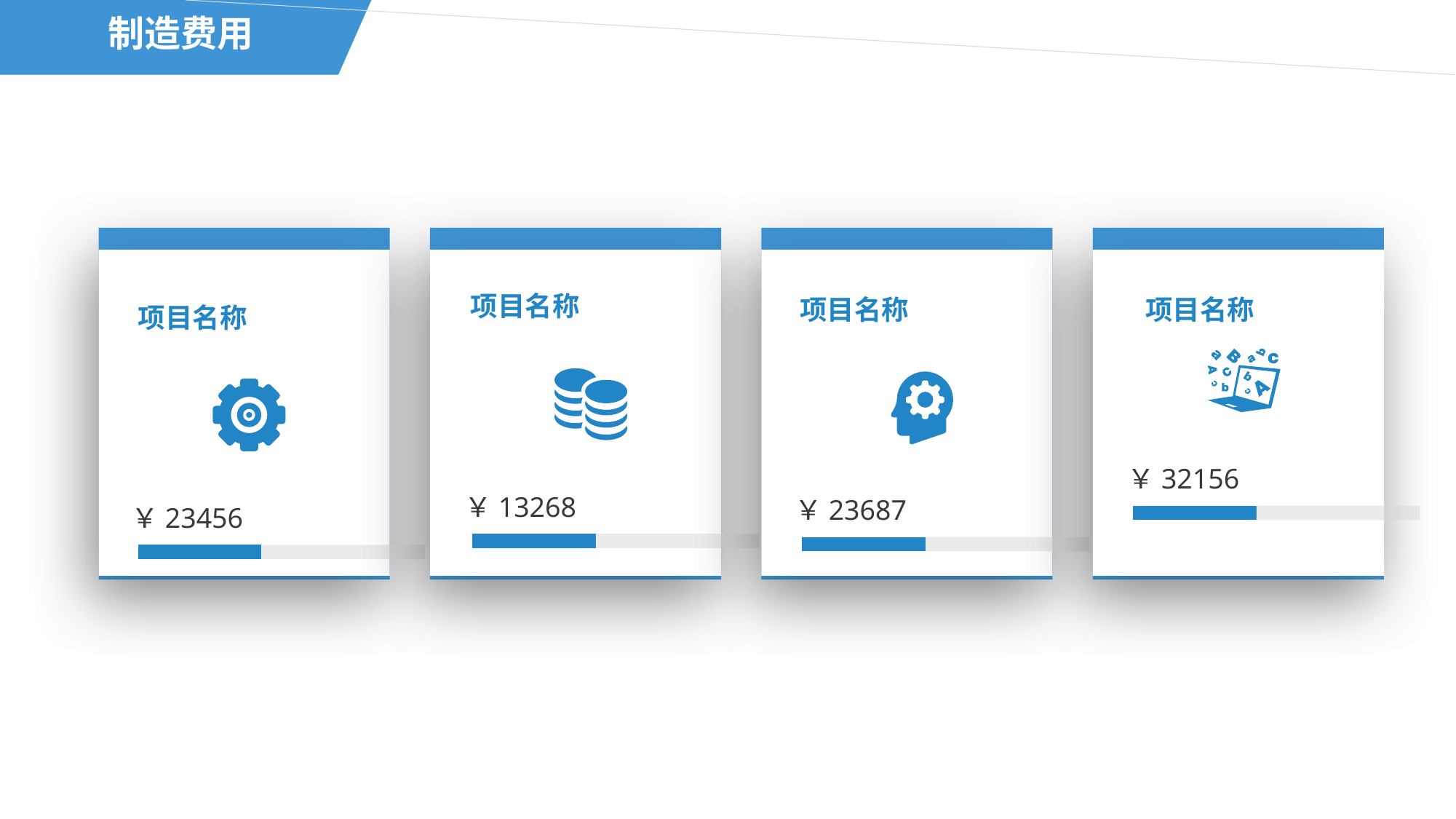
Which card shows the highest value? The fourth card (¥ 32156) What value is shown on the fourth card from the left? ¥ 32156 What is the difference between the value on the fourth card and the value on the second card? 18888 How many cards with values are shown on the slide? 4 What value is shown on the first card from the left? ¥ 23456 What currency symbol is used for the values on the cards? ¥ Which card shows the lowest value? The second card (¥ 13268) Which is larger, the value on the first card or the value on the third card? The third card (¥ 23687) What is the difference between the value on the third card and the value on the first card? 231 What value is shown on the second card from the left? ¥ 13268 What is the title of the slide? 制造费用 What value is shown on the third card from the left? ¥ 23687